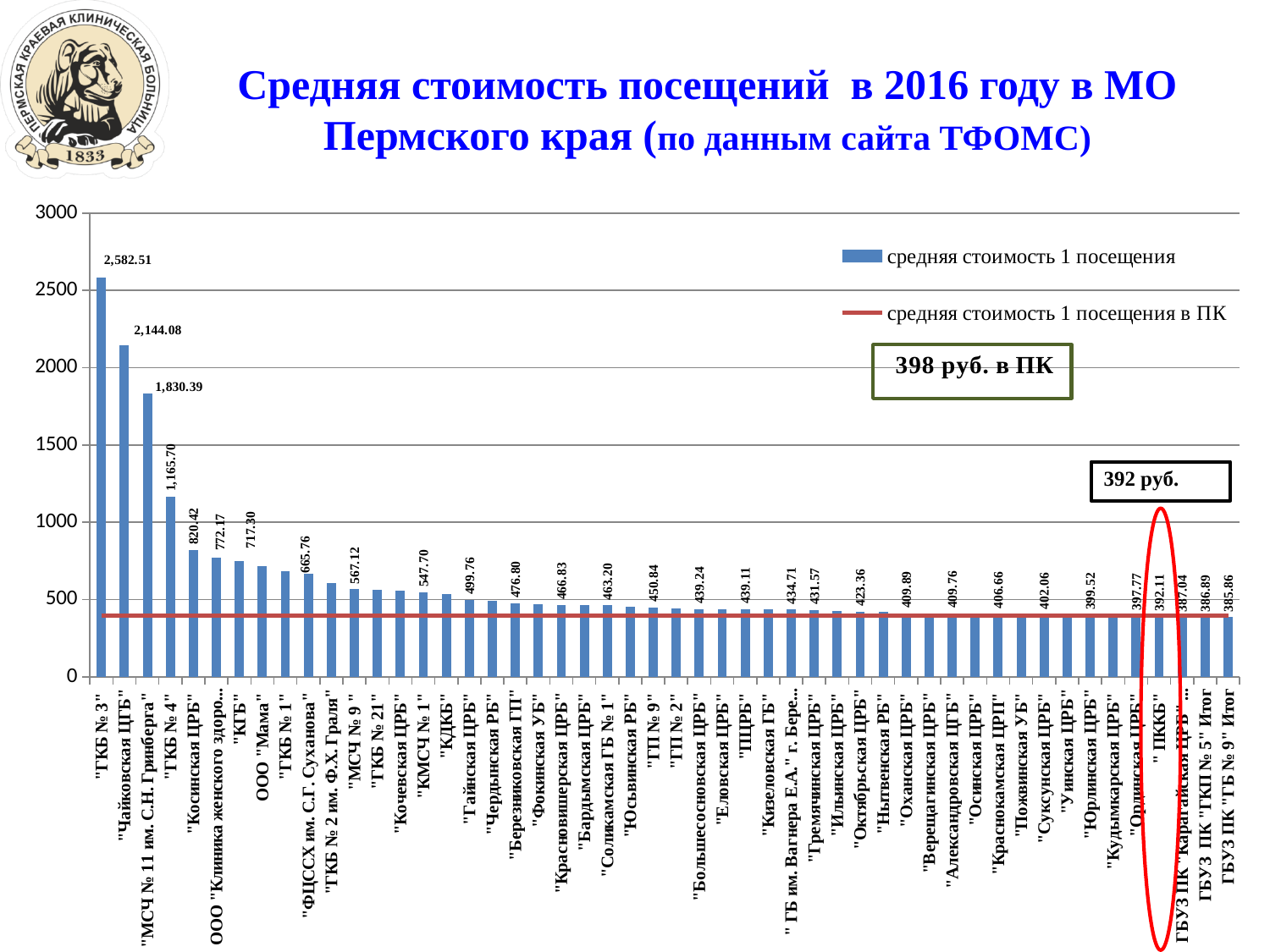
What is the value shown for "Суксунская ЦРБ"? 402.06 Which has a higher average cost per visit, "Косинская ЦРБ" or "КГБ"? "Косинская ЦРБ" Do the bar values rise or fall from left to right along the x axis? fall Which medical organisation has the lowest average cost per visit? ГБУЗ ПК "ГБ № 9" Итог What is the average cost of one visit for "ГКБ № 3"? 2,582.51 What kind of chart is shown on the slide? combination bar and line chart What is the value shown for "ПККБ"? 392.11 Which medical organisation has the highest average cost per visit? "ГКБ № 3" How many series does the legend list? 2 Is the value for ООО "Мама" greater or less than 500? greater Is the value for "ГКБ № 2 им. Ф.Х. Граля" greater or less than 1000? less